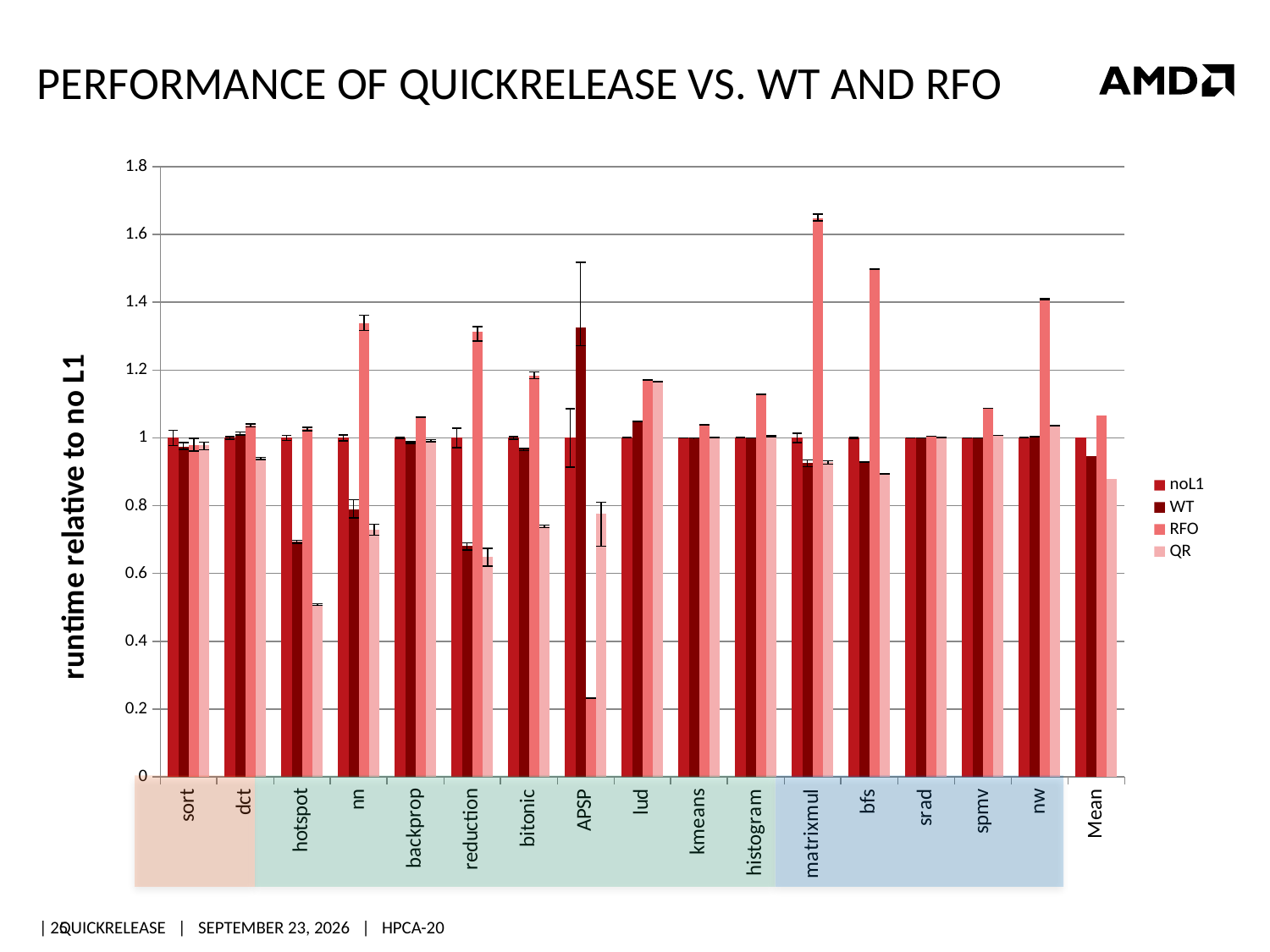
Which is larger, the RFO value for matrixmul or the RFO value for bfs? matrixmul Is the WT value for APSP greater or less than 1.2? greater Is the RFO value for bfs greater or less than 1.4? greater Is the RFO value for matrixmul greater or less than 1.4? greater How many categories are shown along the x axis? 17 Which category has the lowest QR bar? hotspot How many series does the legend list? 4 Which category has the highest RFO bar? matrixmul What kind of chart is shown on the slide? bar chart What is the title of the y axis? runtime relative to no L1